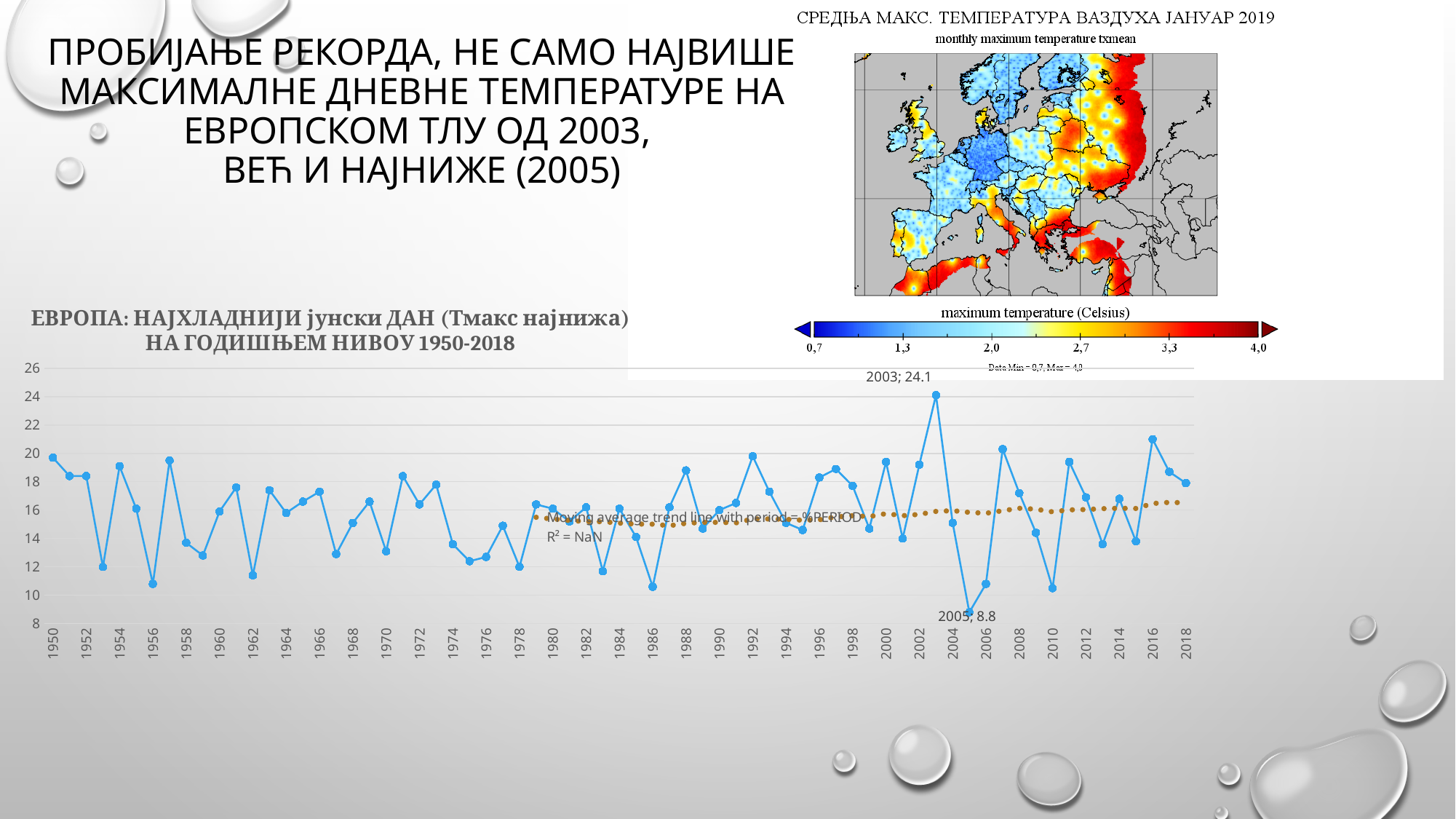
What is the difference between the labelled values for 2003 and 2005 on the line chart? 15.3 What is the highest tick value shown on the y axis of the line chart? 26 Does the dotted moving average trend line on the line chart rise or fall from left to right? rise Is the value for 1986 on the line chart greater or less than 12? less What kind of chart is shown at the bottom of the slide? line chart Is the value for 1950 on the line chart greater or less than 18? greater Which year has the lowest value on the line chart? 2005 What value is labelled for 2005 on the line chart? 8.8 What value is labelled for 2003 on the line chart? 24.1 Which year has the highest value on the line chart? 2003 Is the value for 1956 on the line chart greater or less than 12? less Which year has the larger value on the line chart, 2003 or 2005? 2003